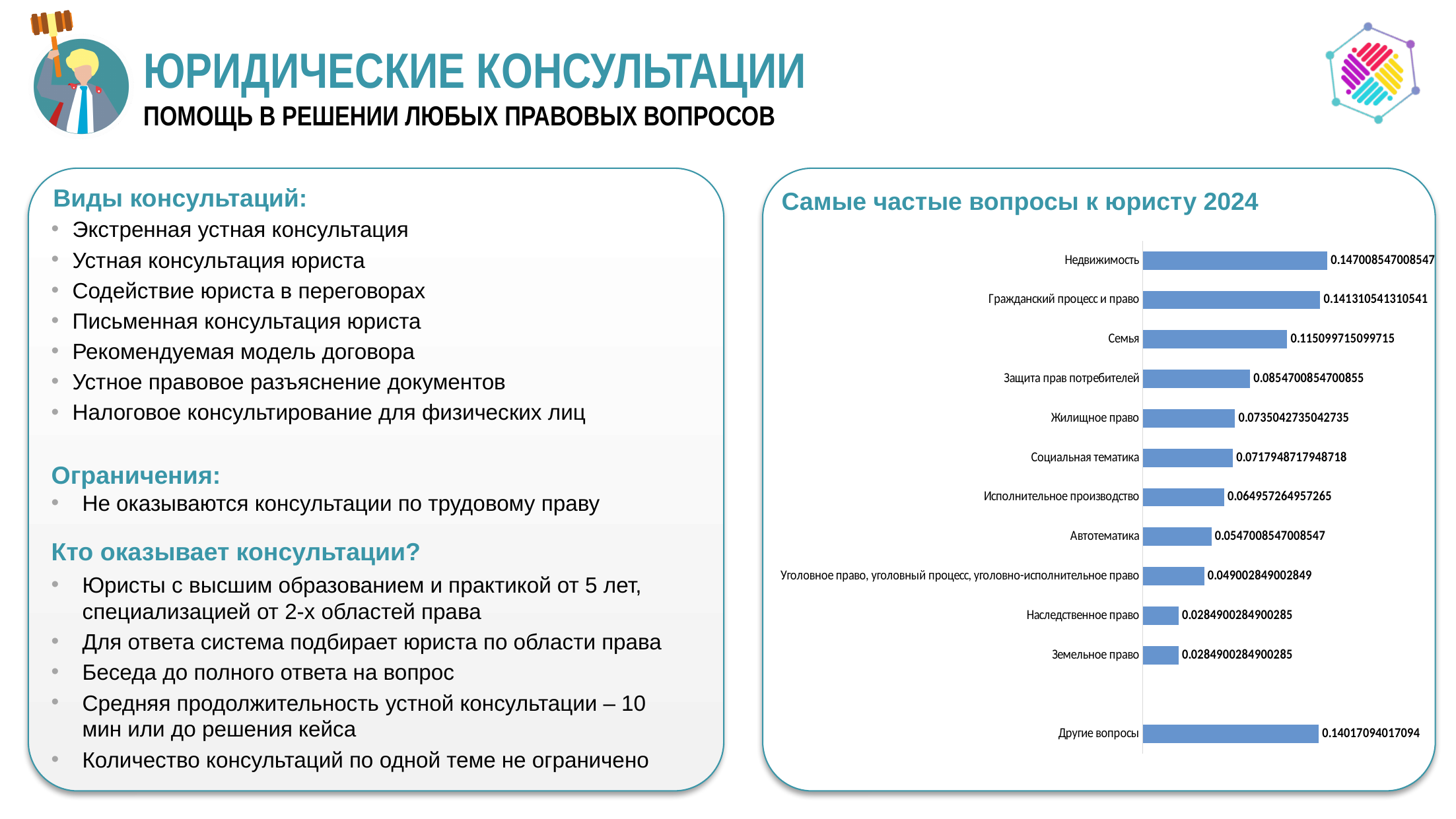
What is the value for Недвижимость in the chart? 0.147008547008547 What is the value for Земельное право in the chart? 0.0284900284900285 Which is larger in the chart: Семья or Другие вопросы? Другие вопросы What is the value for Семья in the chart? 0.115099715099715 How many categories are shown in the chart? 12 What is the value for Автотематика in the chart? 0.0547008547008547 Which is larger in the chart: Жилищное право or Исполнительное производство? Жилищное право What is the title of the chart on the right side of the slide? Самые частые вопросы к юристу 2024 What is the value for Другие вопросы in the chart? 0.14017094017094 What is the value for Защита прав потребителей in the chart? 0.0854700854700855 What type of chart is shown under the title 'Самые частые вопросы к юристу 2024'? bar chart Which category has the highest value in the chart? Недвижимость